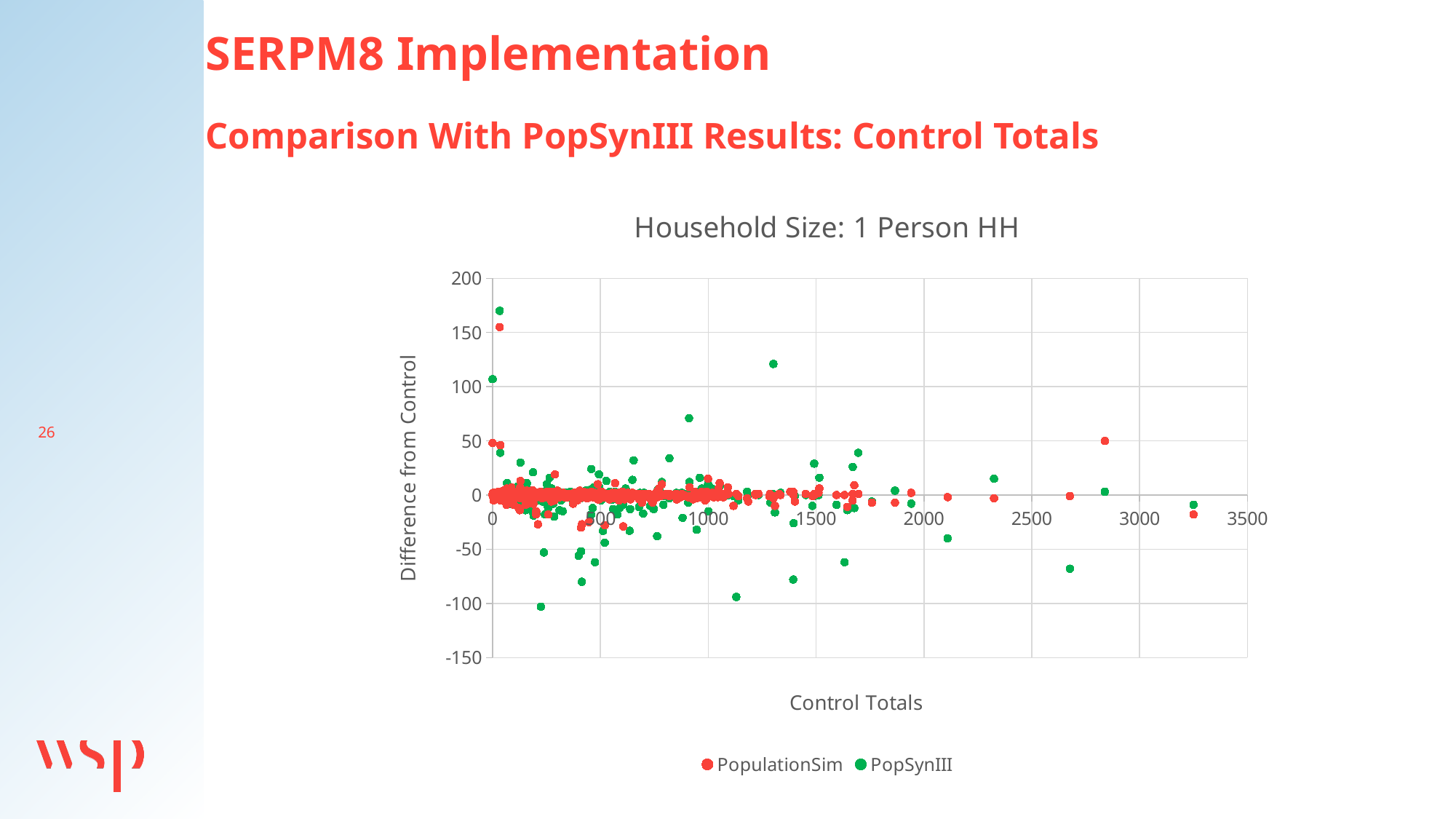
Is the PopSynIII point near a control total of 2700 greater or less than -50? less What kind of chart is shown on the slide? Scatter chart What is the maximum value shown on the vertical axis? 200 Which series is plotted in green? PopSynIII Which series has the highest plotted point on the chart? PopSynIII What is the label of the vertical axis? Difference from Control Is the highest PopSynIII point greater or less than 150? greater Which series has the lowest plotted point on the chart? PopSynIII How many series does the legend list? 2